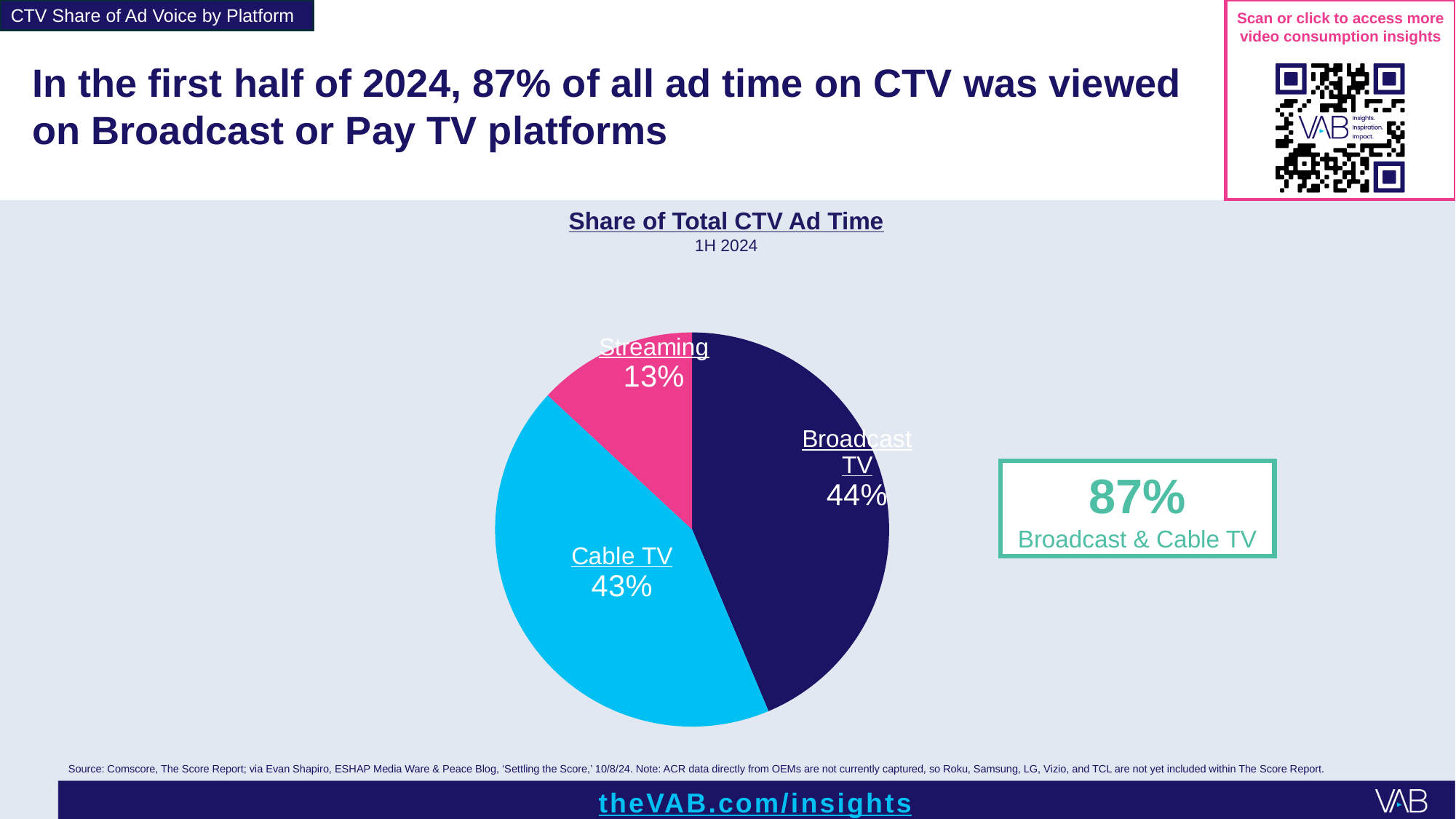
What is the difference in percentage points between the Broadcast TV share and the Cable TV share? 1 What kind of chart is used to show the share of total CTV ad time? Pie chart What is the difference in percentage points between the Cable TV share and the Streaming share? 30 How many platforms are shown in the pie chart? 3 What is the combined share of Broadcast TV and Cable TV? 87% Which platform has the largest share of total CTV ad time? Broadcast TV Which platform has the smallest share of total CTV ad time? Streaming What share of total CTV ad time does Broadcast TV account for? 44% What share of total CTV ad time does Cable TV account for? 43% What time period does the pie chart cover? 1H 2024 Which has a larger share of CTV ad time, Cable TV or Streaming? Cable TV What share of total CTV ad time does Streaming account for? 13%